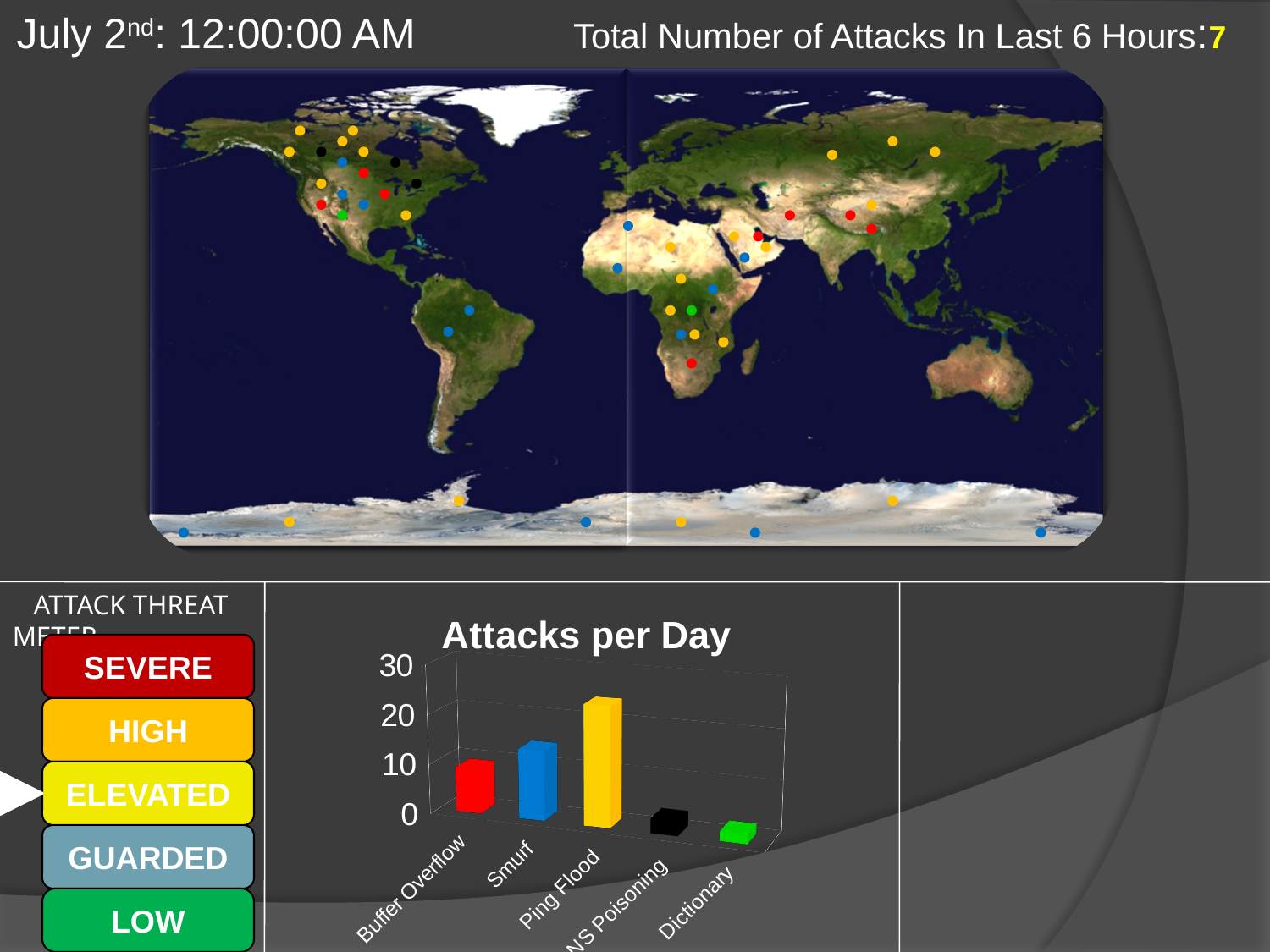
What is the title of the bar chart at the bottom of the slide? Attacks per Day In the "Attacks per Day" chart, is the value for Buffer Overflow greater or less than 20? less In the "Attacks per Day" chart, is the value for Dictionary greater or less than 10? less In the "Attacks per Day" chart, is the value for Smurf greater or less than 20? less How many attack types are shown on the x axis of the "Attacks per Day" chart? 5 In the "Attacks per Day" chart, which is larger, Ping Flood or Smurf? Ping Flood In the "Attacks per Day" chart, which is larger, Buffer Overflow or Dictionary? Buffer Overflow In the "Attacks per Day" chart, what colour is the Ping Flood bar? yellow What kind of chart is the "Attacks per Day" chart? bar chart In the "Attacks per Day" chart, which attack type has the highest value? Ping Flood In the "Attacks per Day" chart, which is larger, Smurf or Buffer Overflow? Smurf